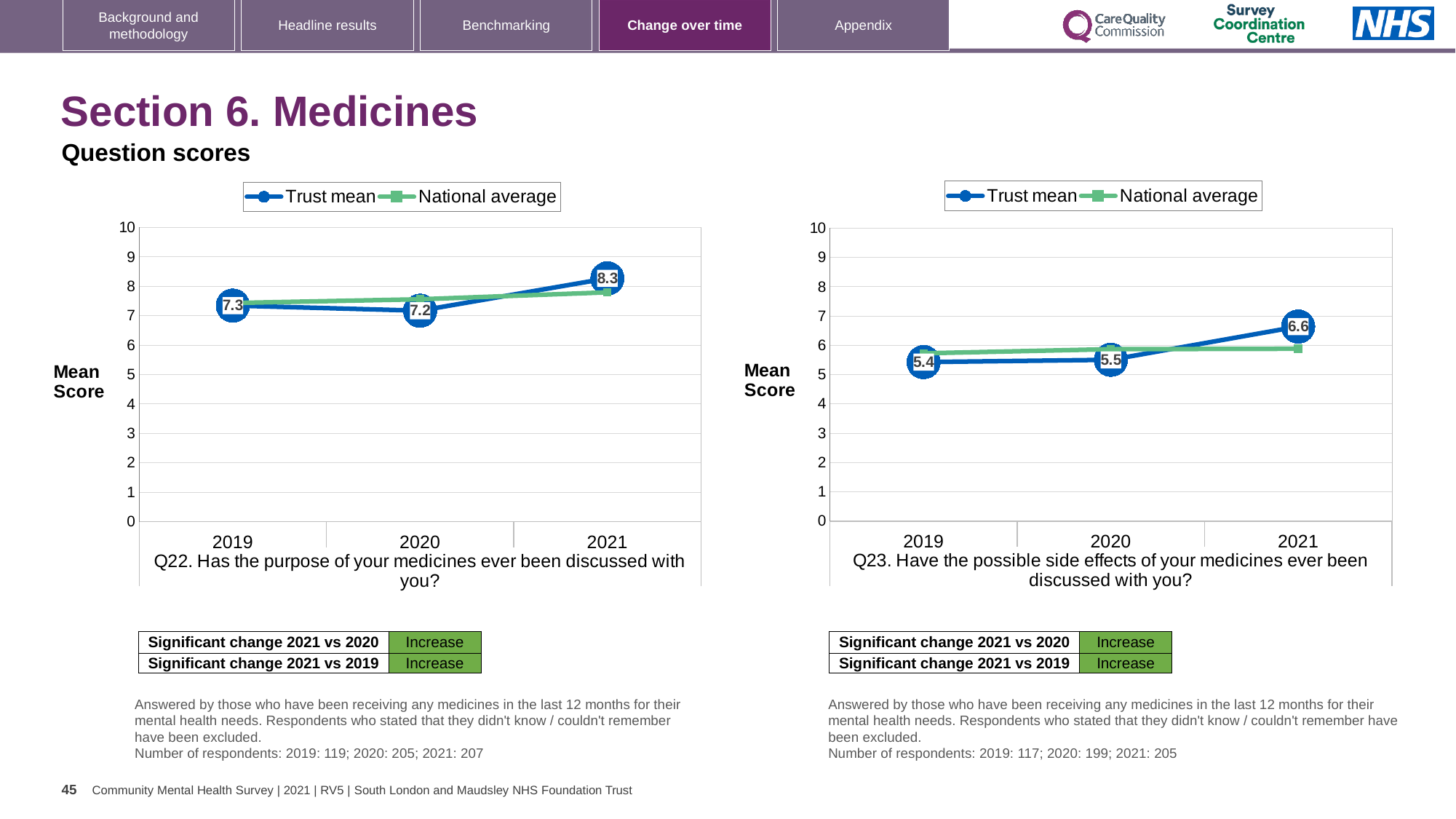
In the Q23 chart on the right, is the National average for 2021 greater or less than 7? less In the Q22 chart on the left, which year has the lowest Trust mean? 2020 In the Q22 chart on the left, what is the Trust mean for 2019? 7.3 In the Q23 chart on the right, which year has the highest Trust mean? 2021 How many series does the legend of the Q23 chart on the right list? 2 In the Q23 chart on the right, what is the Trust mean for 2020? 5.5 In the Q23 chart on the right, what is the difference between the Trust mean in 2021 and in 2019? 1.2 In the Q22 chart on the left, what is the difference between the Trust mean in 2021 and in 2020? 1.1 What type of chart is the Q22 chart on the left? Line chart In the Q23 chart on the right, what is the Trust mean for 2021? 6.6 In the Q22 chart on the left, which is larger in 2021: the Trust mean or the National average? Trust mean In the Q22 chart on the left, what is the Trust mean for 2021? 8.3